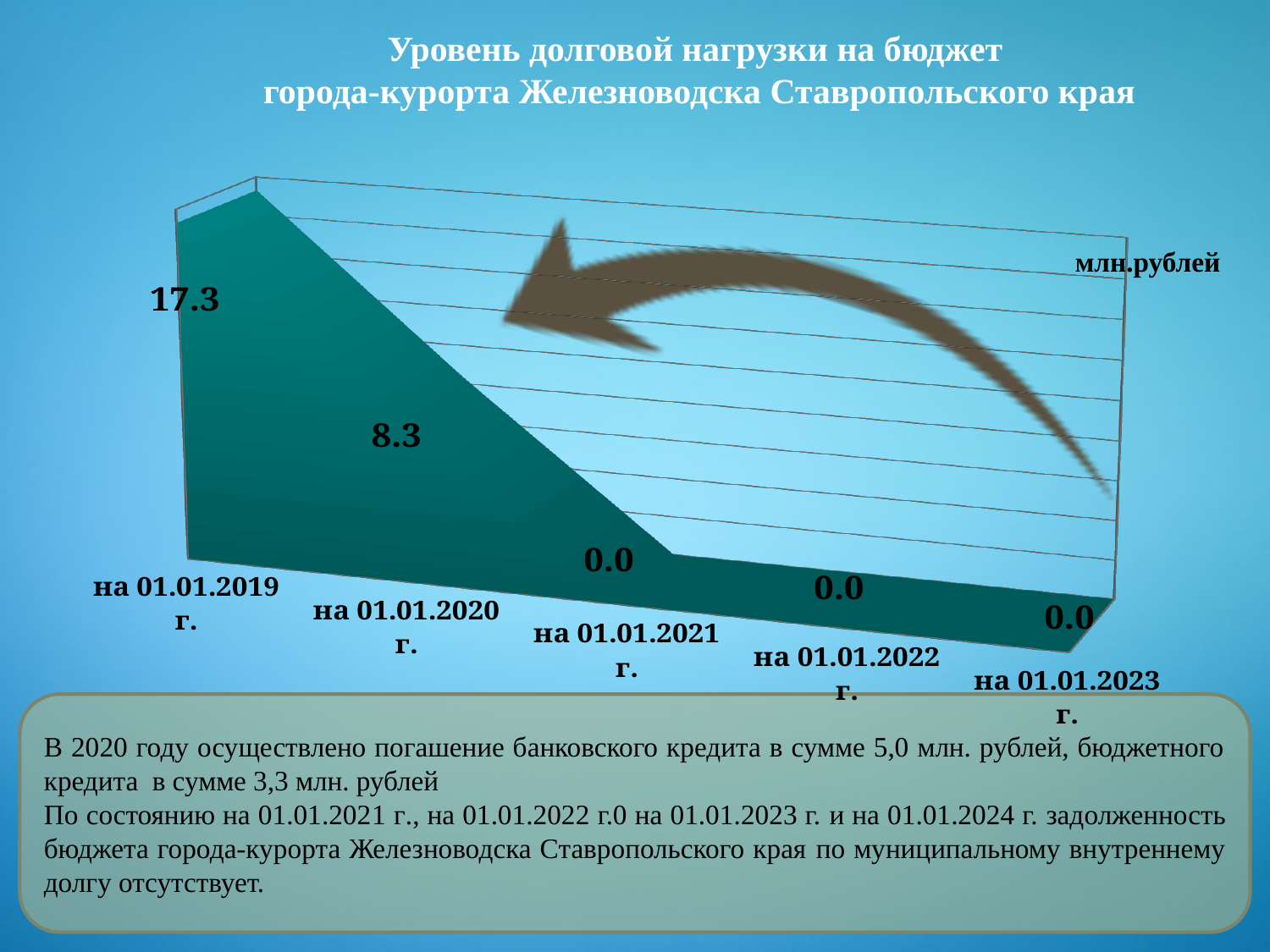
Do the values rise or fall from 01.01.2019 to 01.01.2023? fall What is the title of the chart? Уровень долговой нагрузки на бюджет города-курорта Железноводска Ставропольского края Which is larger, the value for 01.01.2020 or the value for 01.01.2022? 01.01.2020 What kind of chart is shown? area chart How many dates are plotted on the chart? 5 What is the difference between the values for 01.01.2019 and 01.01.2020? 9.0 What is the value for 01.01.2021? 0.0 What is the value for 01.01.2023? 0.0 What unit is shown on the chart? млн.рублей What is the value for 01.01.2020? 8.3 Which date has the highest value? на 01.01.2019 г. What is the value for 01.01.2019? 17.3